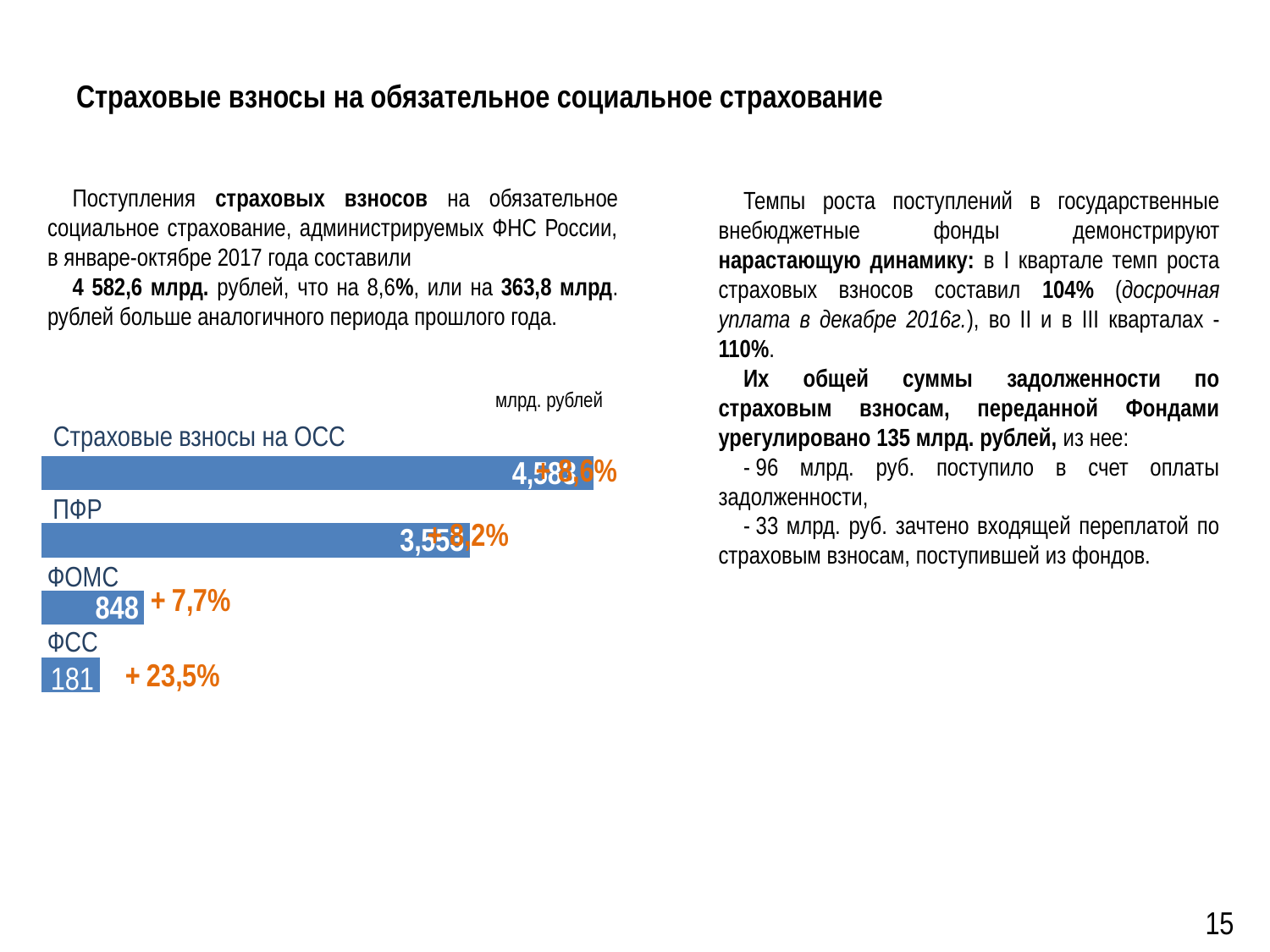
What unit is indicated above the chart? млрд. рублей What is the value for ФОМС in the bar chart? 848 Which category has the longest bar in the chart? Страховые взносы на ОСС What is the difference between the values for ФОМС and ФСС? 667 What type of chart is shown on the slide? bar chart What growth percentage is shown next to the ФСС bar? + 23,5% What growth percentage is shown next to the ФОМС bar? + 7,7% What is the value for ФСС in the bar chart? 181 How many categories are shown in the bar chart? 4 Which category has the shortest bar in the chart? ФСС Which category shows the highest growth percentage in the chart? ФСС Which bar is longer, ПФР or ФОМС? ПФР